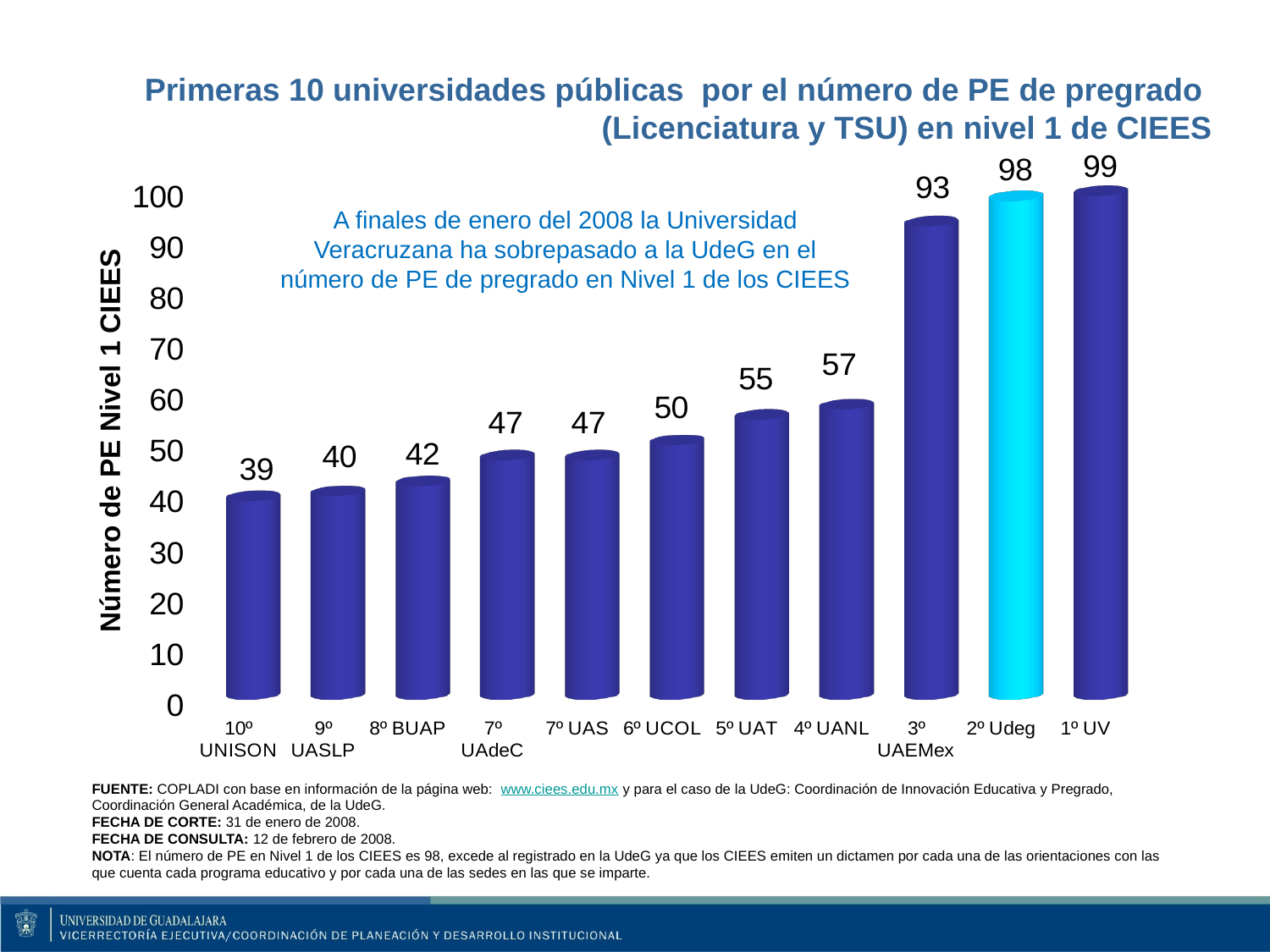
Do the values rise or fall from left to right along the x axis? Rise What is the difference between the values for 1º UV and 2º Udeg? 1 How many universities are shown in the chart? 11 What is the difference between the values for 3º UAEMex and 4º UANL? 36 What is the label of the vertical axis? Número de PE Nivel 1 CIEES What is the value for 2º Udeg? 98 Which university has the highest number of PE Nivel 1 CIEES? 1º UV What is the value for 4º UANL? 57 What is the value for 8º BUAP? 42 Which university has the lowest number of PE Nivel 1 CIEES? 10º UNISON What kind of chart is shown on the slide? Bar chart Which is larger, the value for 5º UAT or the value for 6º UCOL? 5º UAT